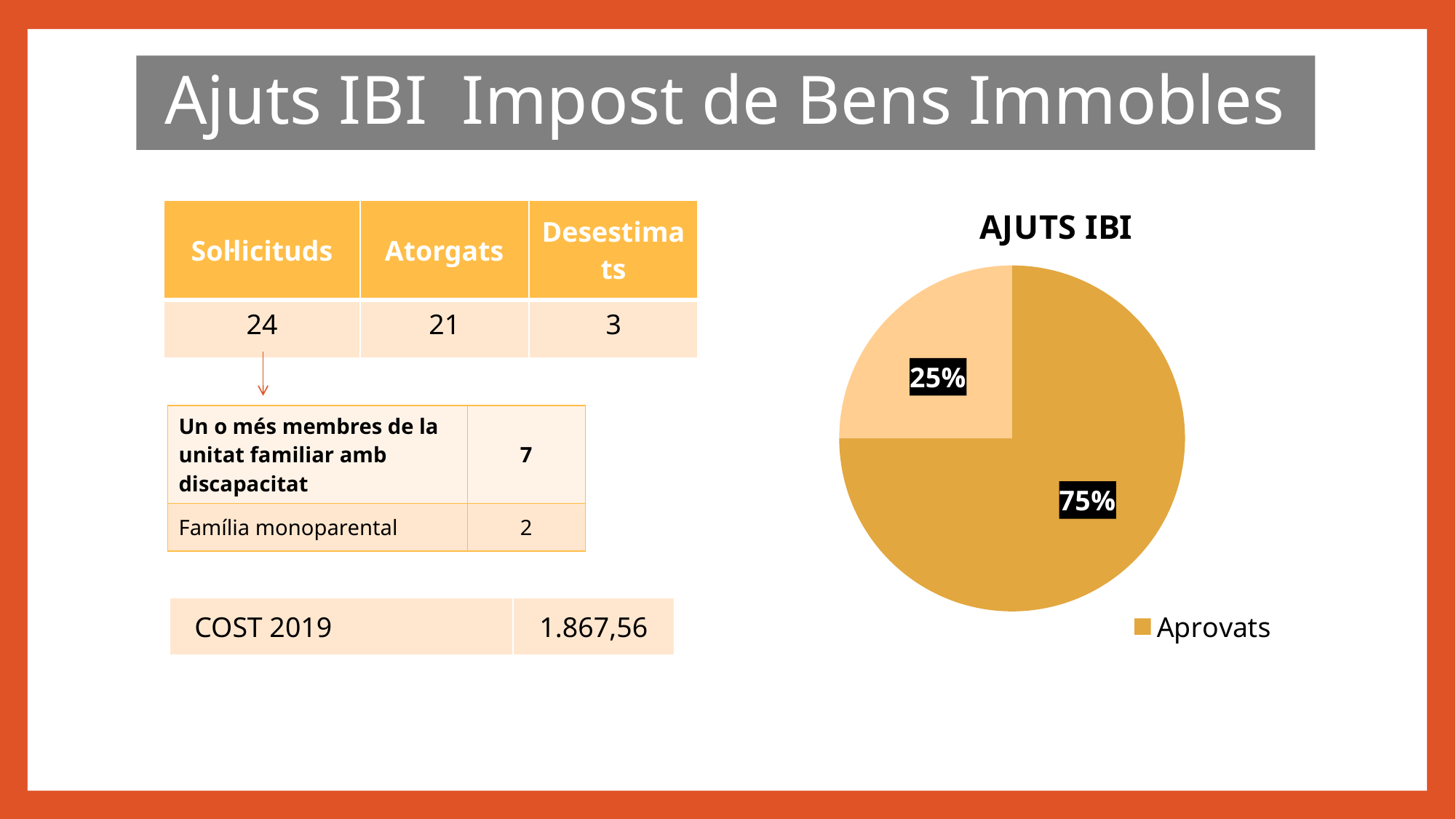
Which slice of the pie chart is the largest? Aprovats (75%) What is the title of the pie chart? AJUTS IBI What do the two percentages shown on the pie chart add up to? 100% How many entries does the pie chart's legend list? 1 What percentage does the Aprovats slice of the pie chart show? 75% What is the only entry shown in the pie chart's legend? Aprovats What kind of chart is shown on the slide? Pie chart How many slices does the pie chart have? 2 Is the Aprovats slice of the pie chart greater or less than 50%? greater Which is larger in the pie chart: the Aprovats slice or the unlabelled lighter slice? Aprovats What percentage is printed on the smaller slice of the pie chart? 25% What is the difference in percentage points between the 75% slice and the 25% slice of the pie chart? 50 percentage points